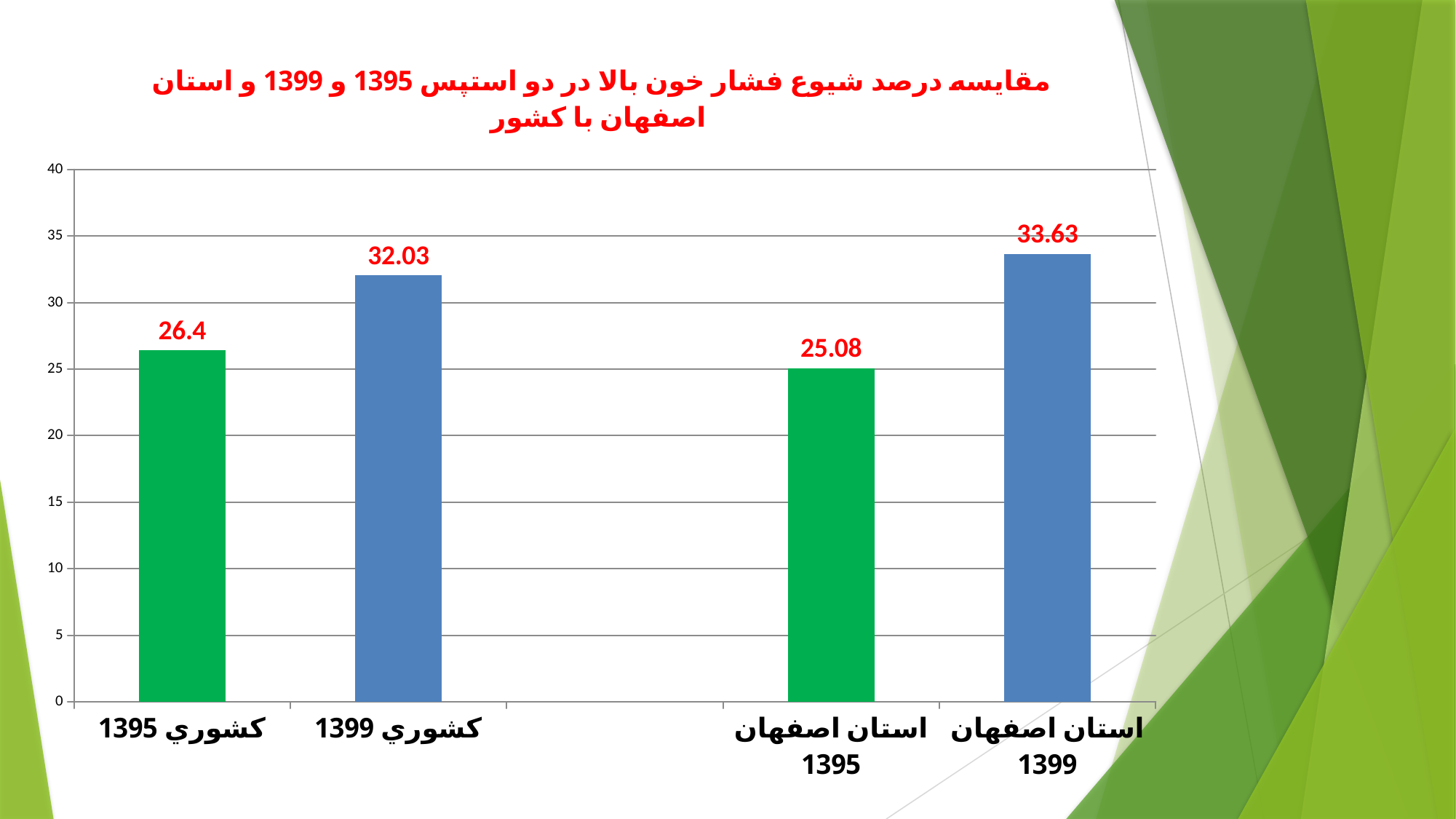
Is the value for استان اصفهان 1399 greater or less than 30? greater What is the value for کشوري 1399? 32.03 What is the difference between the values for کشوري 1399 and کشوري 1395? 5.63 Which category has the lowest value? استان اصفهان 1395 What is the difference between the values for استان اصفهان 1399 and استان اصفهان 1395? 8.55 What is the value for استان اصفهان 1399? 33.63 Which category has the highest value? استان اصفهان 1399 How many bars are shown in the chart? 4 Which is larger, the value for کشوري 1395 or the value for استان اصفهان 1395? کشوري 1395 What is the value for کشوري 1395? 26.4 What is the value for استان اصفهان 1395? 25.08 What kind of chart is shown on the slide? bar chart